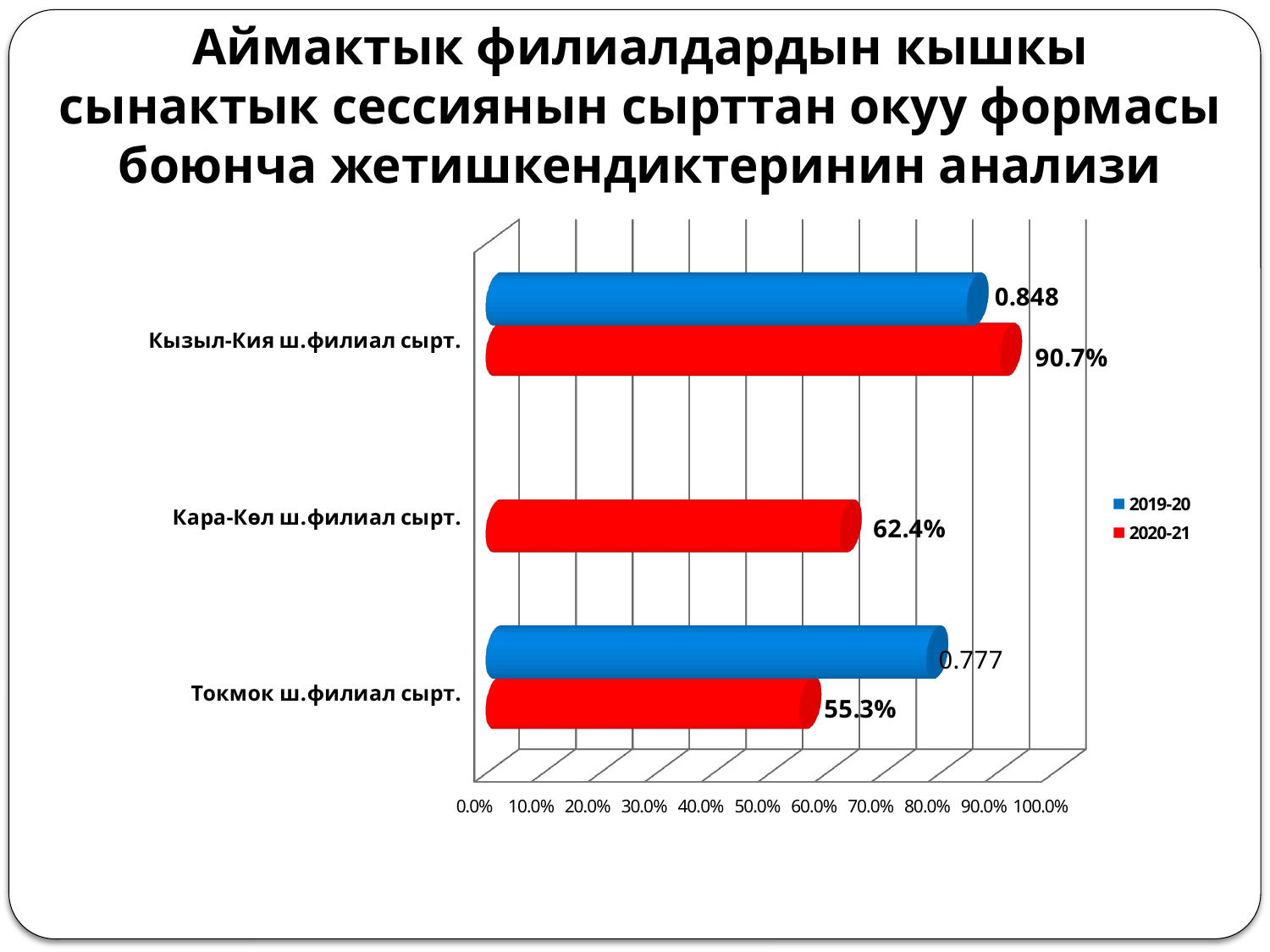
What is the 2020-21 value for Кызыл-Кия ш.филиал сырт.? 90.7% What is the 2019-20 value for Токмок ш.филиал сырт.? 0.777 What is the 2020-21 value for Кара-Көл ш.филиал сырт.? 62.4% What type of chart is shown on the slide? bar chart How many series does the legend list? 2 How many categories are shown on the vertical axis of the chart? 3 What is the 2020-21 value for Токмок ш.филиал сырт.? 55.3% Which colour represents the 2020-21 series in the legend? red Which category has the highest 2020-21 value? Кызыл-Кия ш.филиал сырт. What is the 2019-20 value for Кызыл-Кия ш.филиал сырт.? 0.848 What is the difference between the 2020-21 values for Кызыл-Кия ш.филиал сырт. and Кара-Көл ш.филиал сырт.? 28.3% Which category has the lowest 2020-21 value? Токмок ш.филиал сырт.